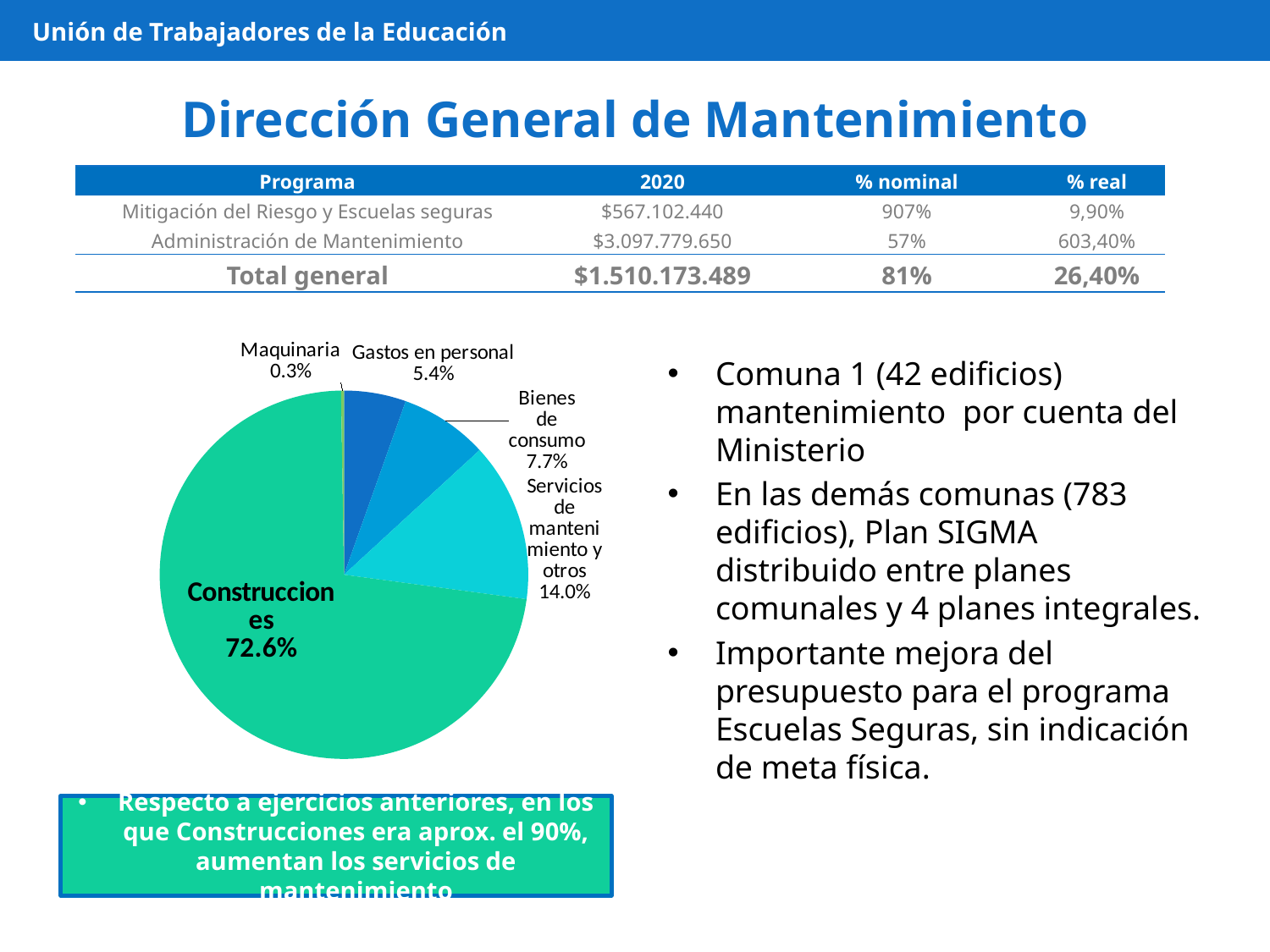
What kind of chart is shown on the slide? pie chart How many slices does the pie chart have? 5 What is the value shown for Maquinaria? 0.3% Which category has the smallest slice of the pie? Maquinaria Which category has the largest slice of the pie? Construcciones Which is larger, Bienes de consumo or Gastos en personal? Bienes de consumo What is the difference between the Construcciones share and the Servicios de mantenimiento y otros share? 58.6% What is the value shown for Servicios de mantenimiento y otros? 14.0% What is the value shown for Gastos en personal? 5.4% What is the difference between the Bienes de consumo share and the Gastos en personal share? 2.3% What is the value shown for Bienes de consumo? 7.7% What share of the pie does Construcciones represent? 72.6%